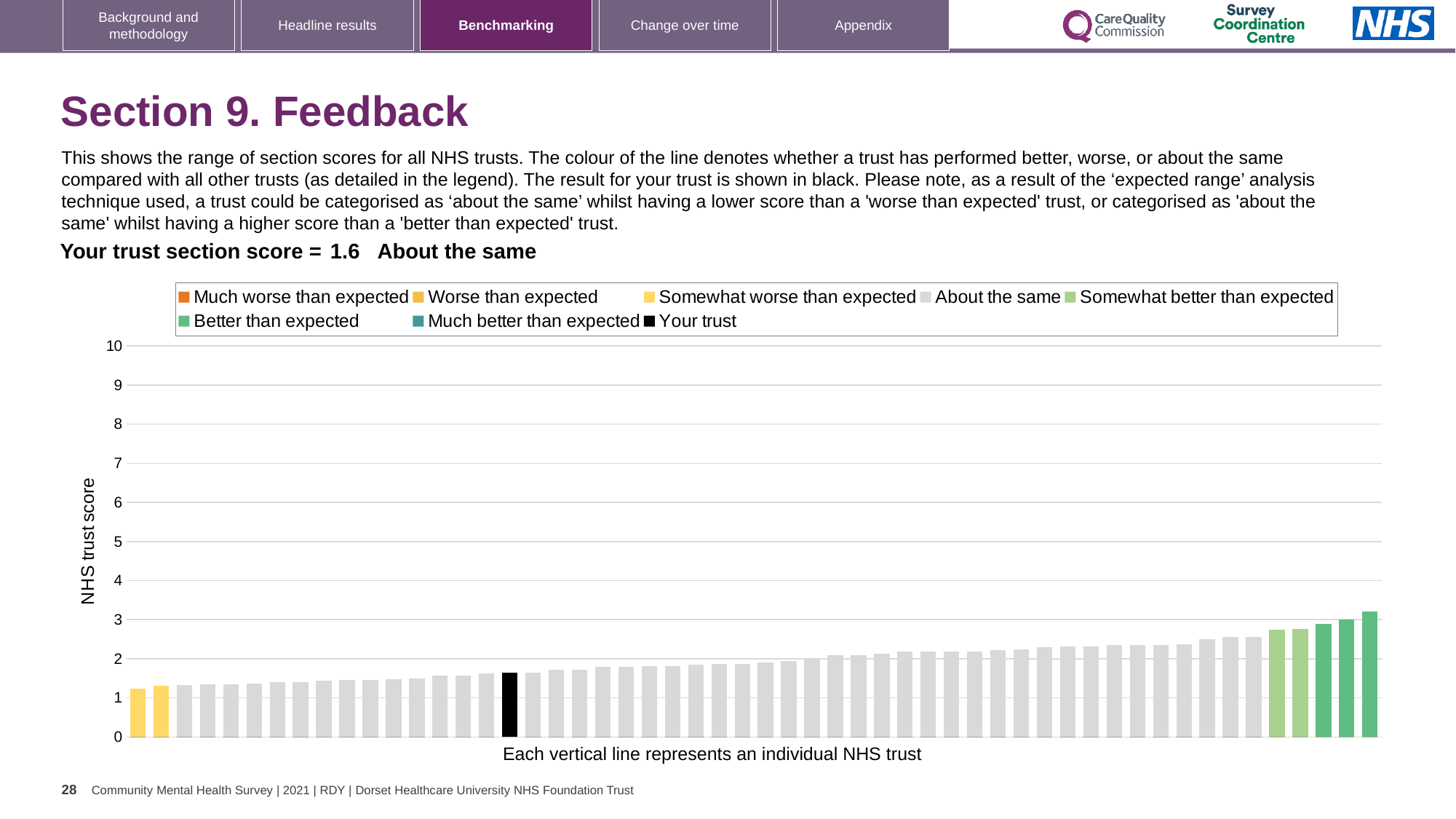
Is the value for your trust (the black bar) greater or less than 1? greater Is the value for your trust (the black bar) greater or less than 2? less What is the label on the vertical axis of the chart? NHS trust score Which performance category is your trust placed in for this section? About the same Which legend category do the tallest bars on the right of the chart belong to? Better than expected Is the tallest bar in the chart greater or less than 4? less What kind of chart is shown on the slide? Bar chart Do the bar values rise or fall from left to right along the x axis? rise What is the section score for your trust shown on the slide? 1.6 How many entries does the chart legend list? 8